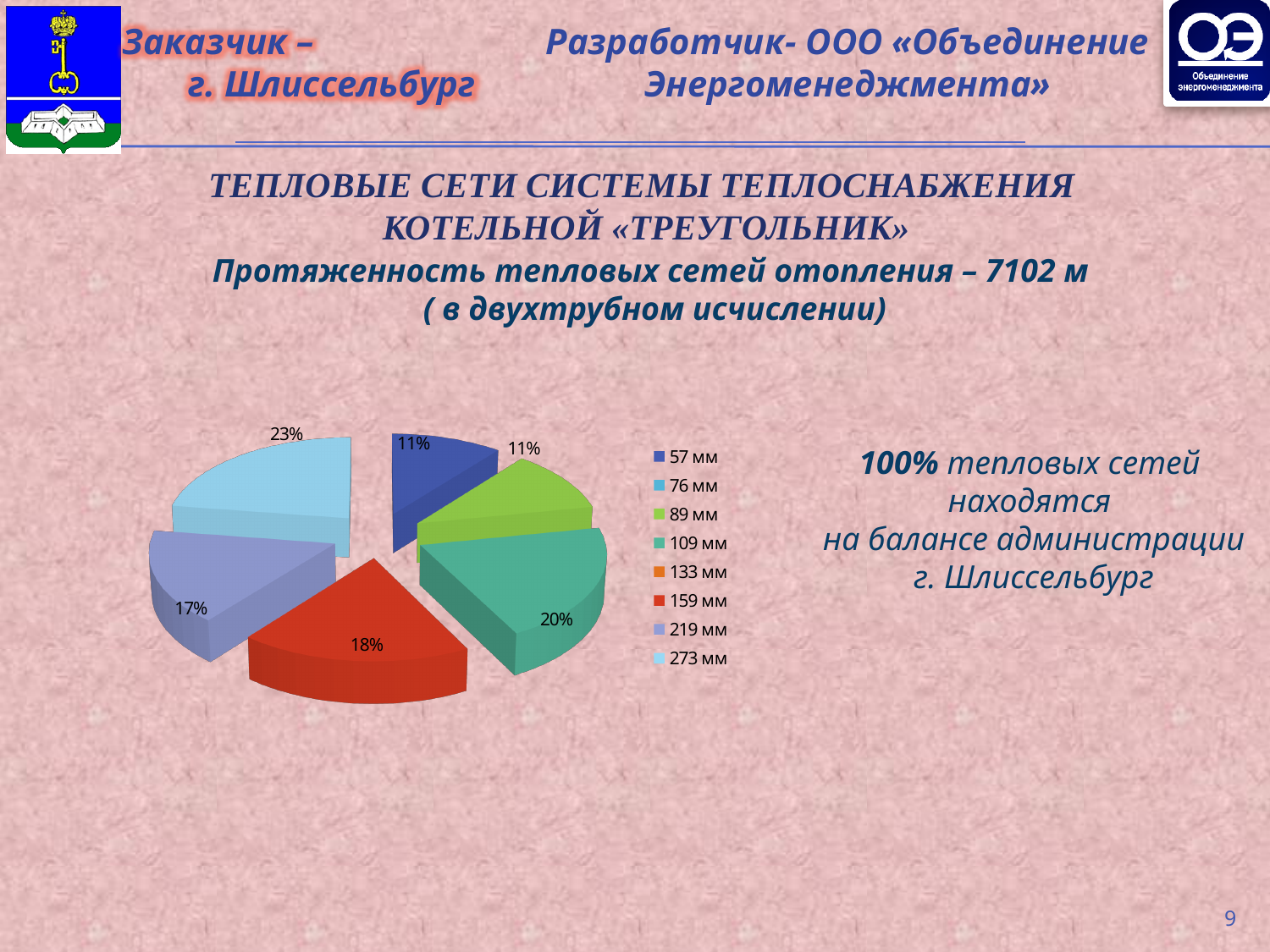
Which slice is larger, 109 мм or 159 мм? 109 мм What share of the pie does the 109 мм slice have? 20% What share of the pie does the 57 мм slice have? 11% How many entries does the legend list? 8 Which slice is larger, 273 мм or 219 мм? 273 мм What share of the pie does the 219 мм slice have? 17% What kind of chart is shown on the slide? pie chart According to the slide text, what is the total length of the heating networks? 7102 м What share of the pie does the 159 мм slice have? 18% What share of the pie does the 273 мм slice have? 23% What is the difference in percentage points between the 273 мм slice and the 219 мм slice? 6 Which pipe diameter has the largest share of the pie? 273 мм